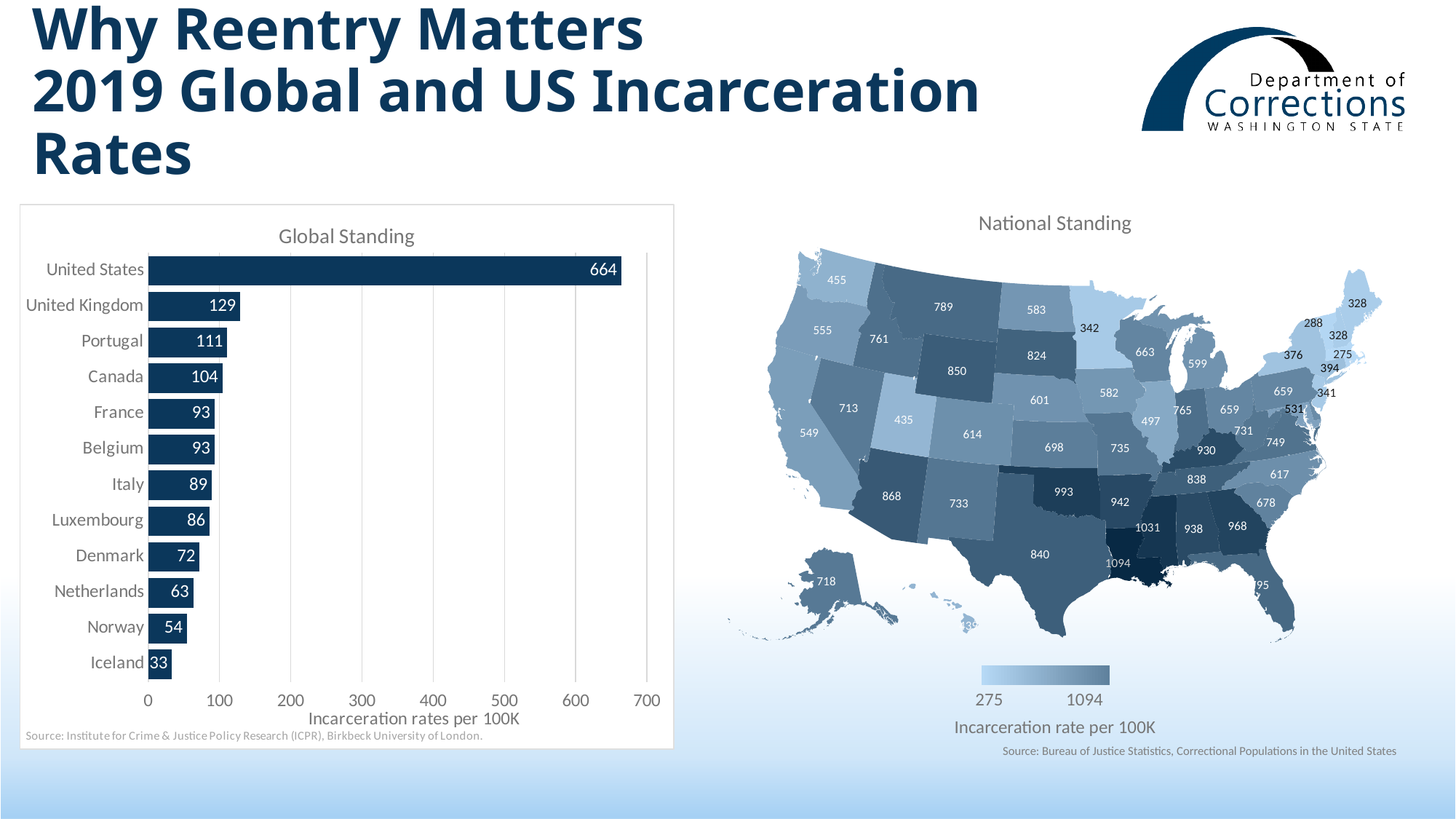
In the Global Standing chart, which has a higher incarceration rate, Italy or Luxembourg? Italy On the National Standing map, what is the highest value shown on the colour legend scale? 1094 How many countries are shown in the Global Standing chart? 12 In the Global Standing chart, what is the incarceration rate per 100K for Canada? 104 What kind of chart is the Global Standing chart? Bar chart In the Global Standing chart, which country has the lowest incarceration rate? Iceland In the Global Standing chart, what is the incarceration rate per 100K for the United States? 664 In the Global Standing chart, what is the difference between the incarceration rates of the United States and the United Kingdom? 535 In the Global Standing chart, which country has the highest incarceration rate? United States In the Global Standing chart, is the value for the United Kingdom greater or less than 100? greater In the Global Standing chart, what is the difference between the incarceration rates of Portugal and Denmark? 39 In the Global Standing chart, what is the incarceration rate per 100K for Norway? 54